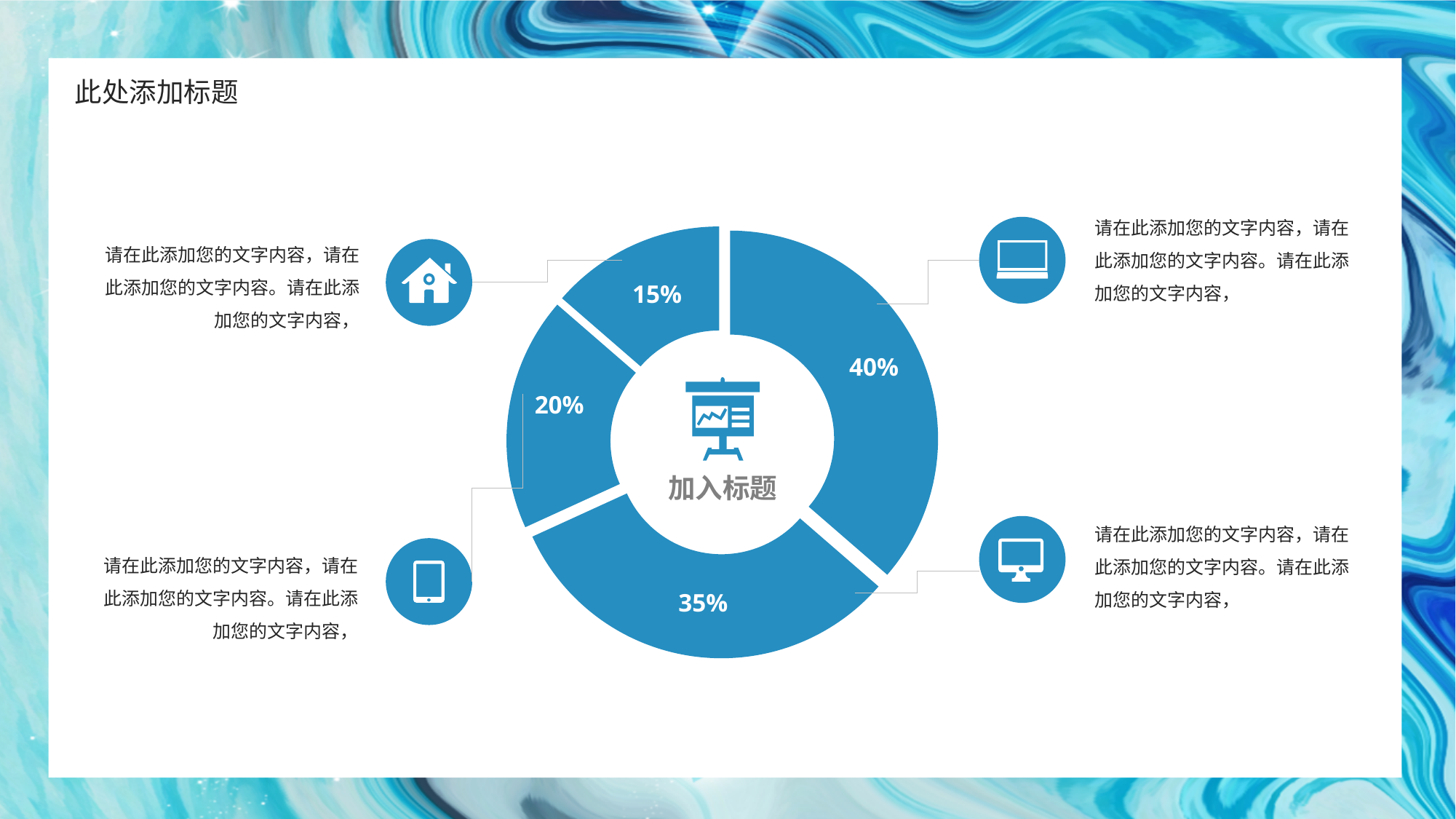
What kind of chart is shown on the slide? Pie chart (donut) What value is shown on the slice at the bottom of the pie chart? 35% Which is larger, the slice at the bottom of the pie chart or the slice on the left? The bottom slice (35%) What is the difference between the largest and smallest slices of the pie chart? 25% What value is shown on the slice connected to the house icon? 15% How many slices does the pie chart have? 4 What text appears in the centre of the donut chart? 加入标题 What is the smallest value shown in the pie chart? 15% What is the largest value shown in the pie chart? 40% What is the title of the slide? 此处添加标题 What is the difference between the 40% slice and the 35% slice? 5% What value is shown on the slice on the right side of the pie chart? 40%